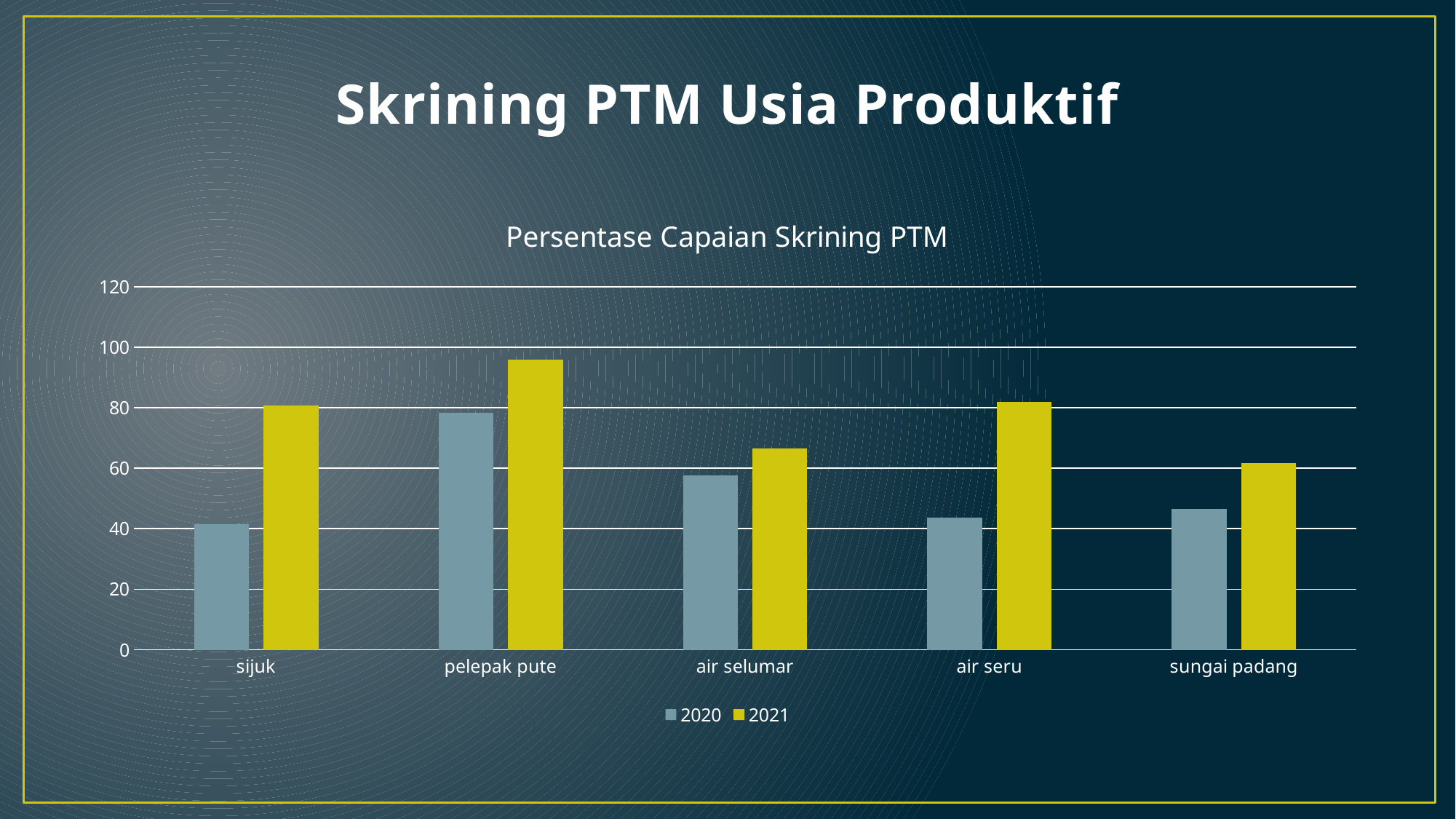
For sijuk, which series has the larger value, 2020 or 2021? 2021 Which category has the highest value for 2020? pelepak pute How many series does the legend list? 2 Is the 2021 value for pelepak pute greater or less than 100? less Is the 2021 value for air selumar greater or less than 60? greater How many categories are shown on the x axis? 5 Is the 2020 value for sungai padang greater or less than 60? less What is the title of the chart? Persentase Capaian Skrining PTM Which category has the highest value for 2021? pelepak pute Which has the larger 2021 value, air seru or sungai padang? air seru What kind of chart is shown on the slide? bar chart